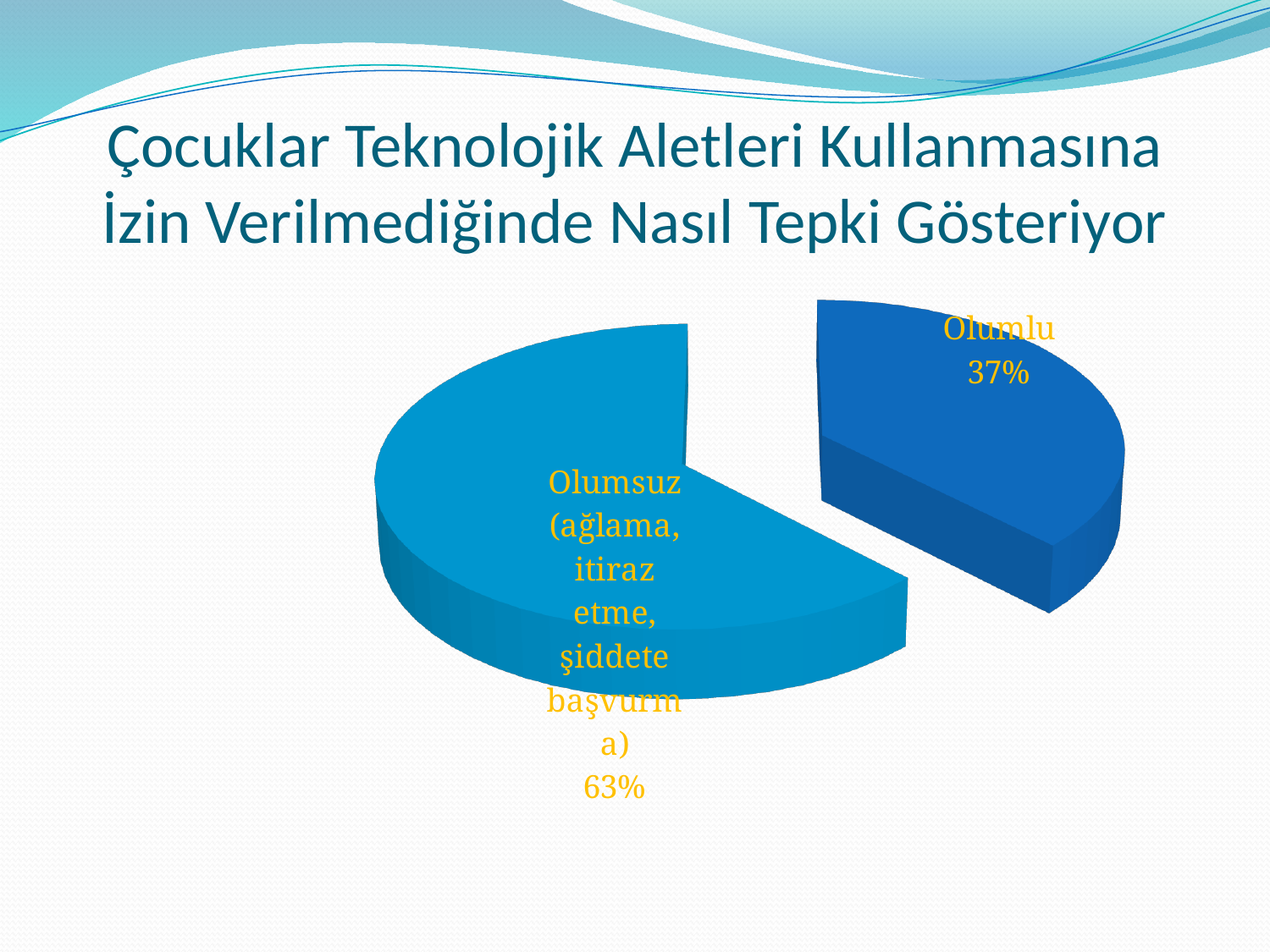
What percentage of the pie is labelled Olumsuz (ağlama, itiraz etme, şiddete başvurma)? 63% Which slice of the pie is the smallest? Olumlu What is the difference in percentage points between the Olumsuz slice and the Olumlu slice? 26 What share of the pie does the Olumlu slice represent? 37% Which is larger, the Olumlu slice or the Olumsuz slice? Olumsuz What is the title of the slide? Çocuklar Teknolojik Aletleri Kullanmasına İzin Verilmediğinde Nasıl Tepki Gösteriyor Which slice of the pie is the largest? Olumsuz (ağlama, itiraz etme, şiddete başvurma) Is the Olumlu slice greater or less than 50% of the pie? less What percentage of the pie is labelled Olumlu? 37% What kind of chart is shown on the slide? Pie chart What do the two slice percentages add up to? 100% How many slices does the pie chart have? 2